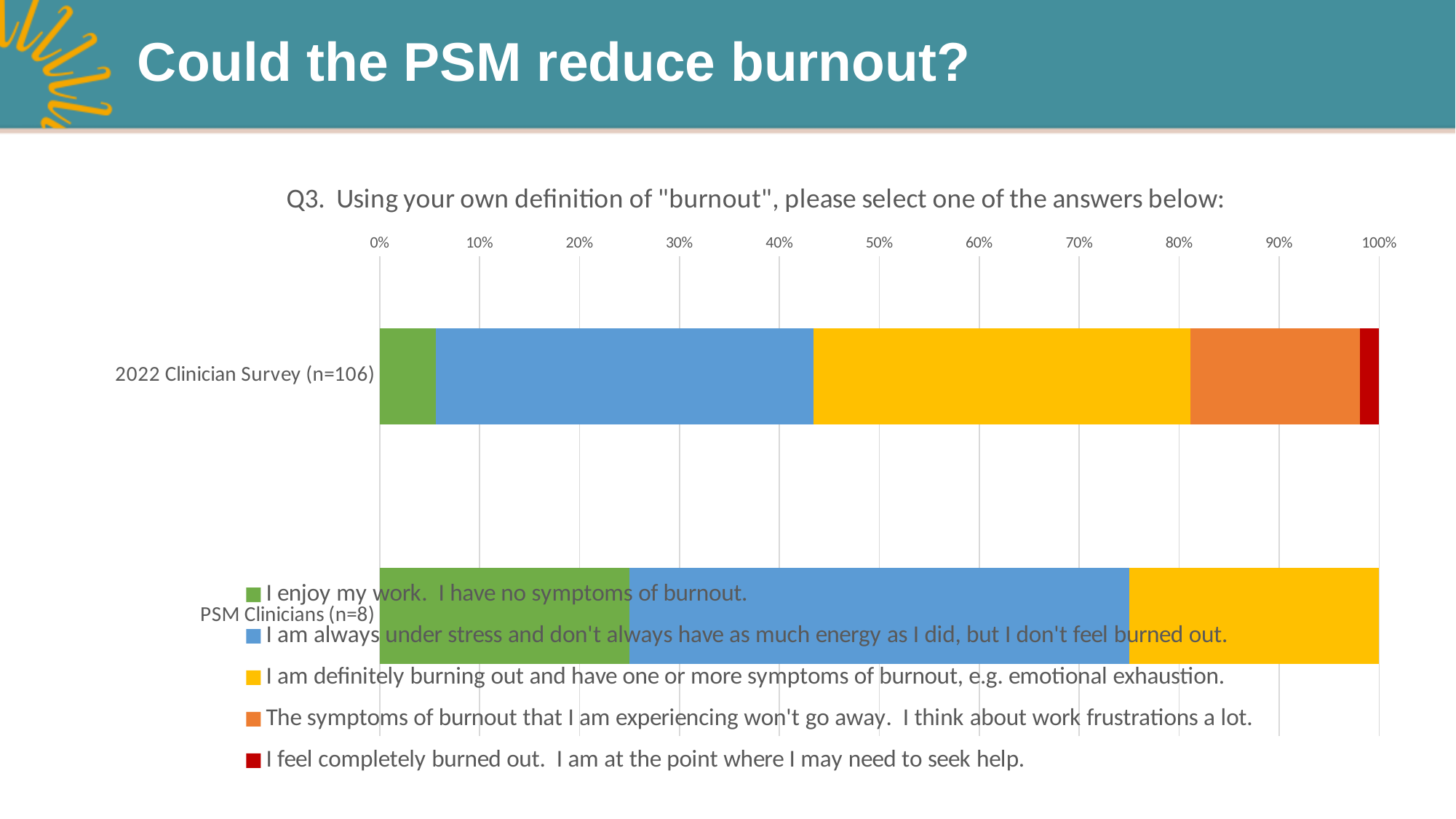
Is the share of "I feel completely burned out. I am at the point where I may need to seek help." for the 2022 Clinician Survey (n=106) greater or less than 10%? less How many categories (bars) does the chart show? 2 Which category has the larger share of "I am definitely burning out and have one or more symptoms of burnout, e.g. emotional exhaustion.": 2022 Clinician Survey (n=106) or PSM Clinicians (n=8)? 2022 Clinician Survey (n=106) Which colour represents "I feel completely burned out. I am at the point where I may need to seek help." in the legend? Dark red Which category has the larger share of "I am always under stress and don't always have as much energy as I did, but I don't feel burned out.": 2022 Clinician Survey (n=106) or PSM Clinicians (n=8)? PSM Clinicians (n=8) What is the title of the chart? Q3. Using your own definition of "burnout", please select one of the answers below: What kind of chart is shown on the slide? Stacked bar chart Is the share of "The symptoms of burnout that I am experiencing won't go away. I think about work frustrations a lot." for the 2022 Clinician Survey (n=106) greater or less than 10%? greater Is the share of "I enjoy my work. I have no symptoms of burnout." for the 2022 Clinician Survey (n=106) greater or less than 10%? less How many series does the legend list? 5 Which category has the larger share of "I enjoy my work. I have no symptoms of burnout.": 2022 Clinician Survey (n=106) or PSM Clinicians (n=8)? PSM Clinicians (n=8)